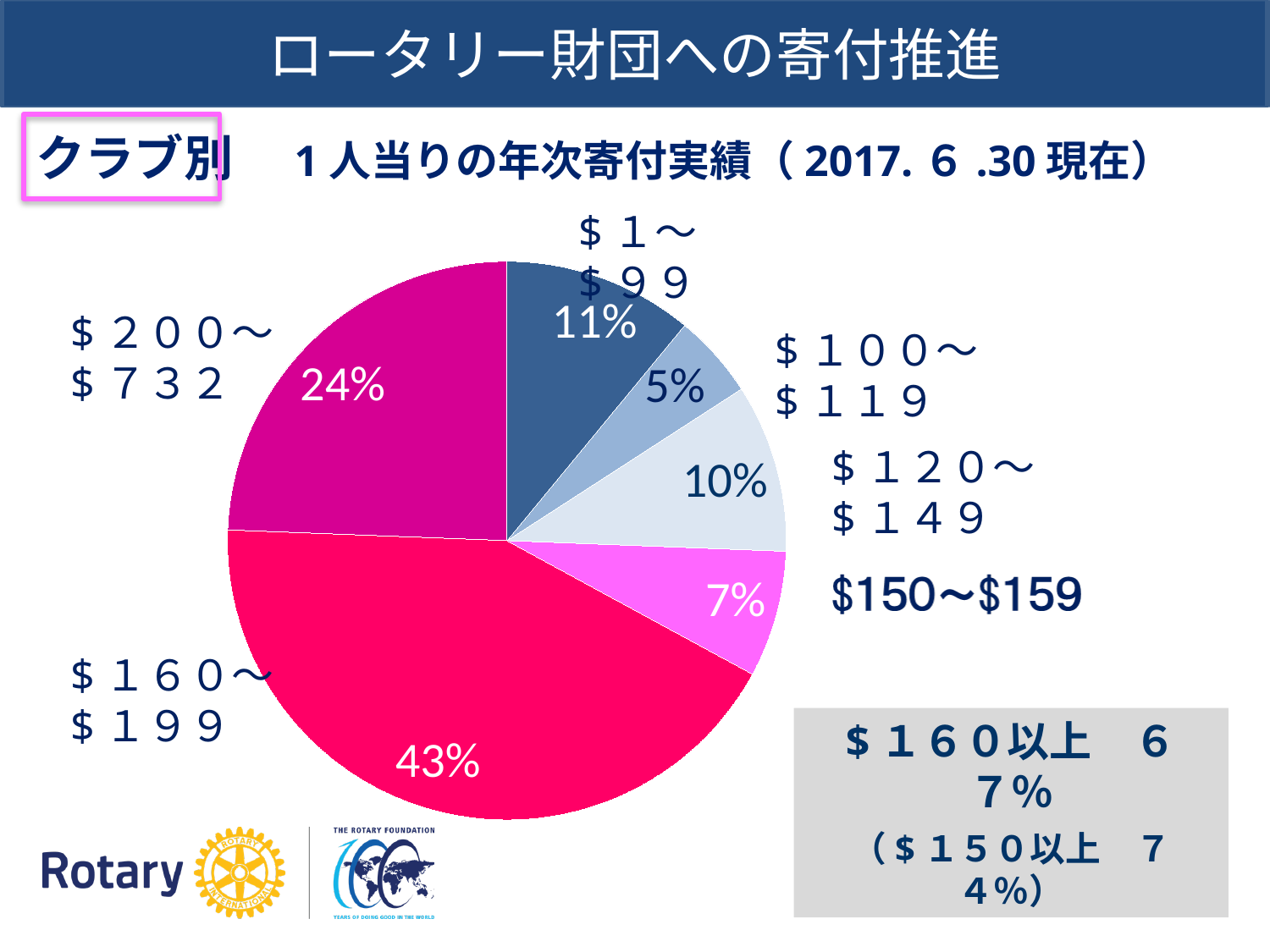
Which category has the largest slice of the pie? $160〜$199 What share of the pie is the $100〜$119 slice? 5% What share of the pie is the $200〜$732 slice? 24% Which category has the smallest slice of the pie? $100〜$119 What share of the pie is the $1〜$99 slice? 11% What kind of chart is shown on the slide? pie chart How many slices does the pie chart have? 6 Which slice is larger, $1〜$99 or $120〜$149? $1〜$99 What is the difference in percentage points between the $160〜$199 slice and the $200〜$732 slice? 19